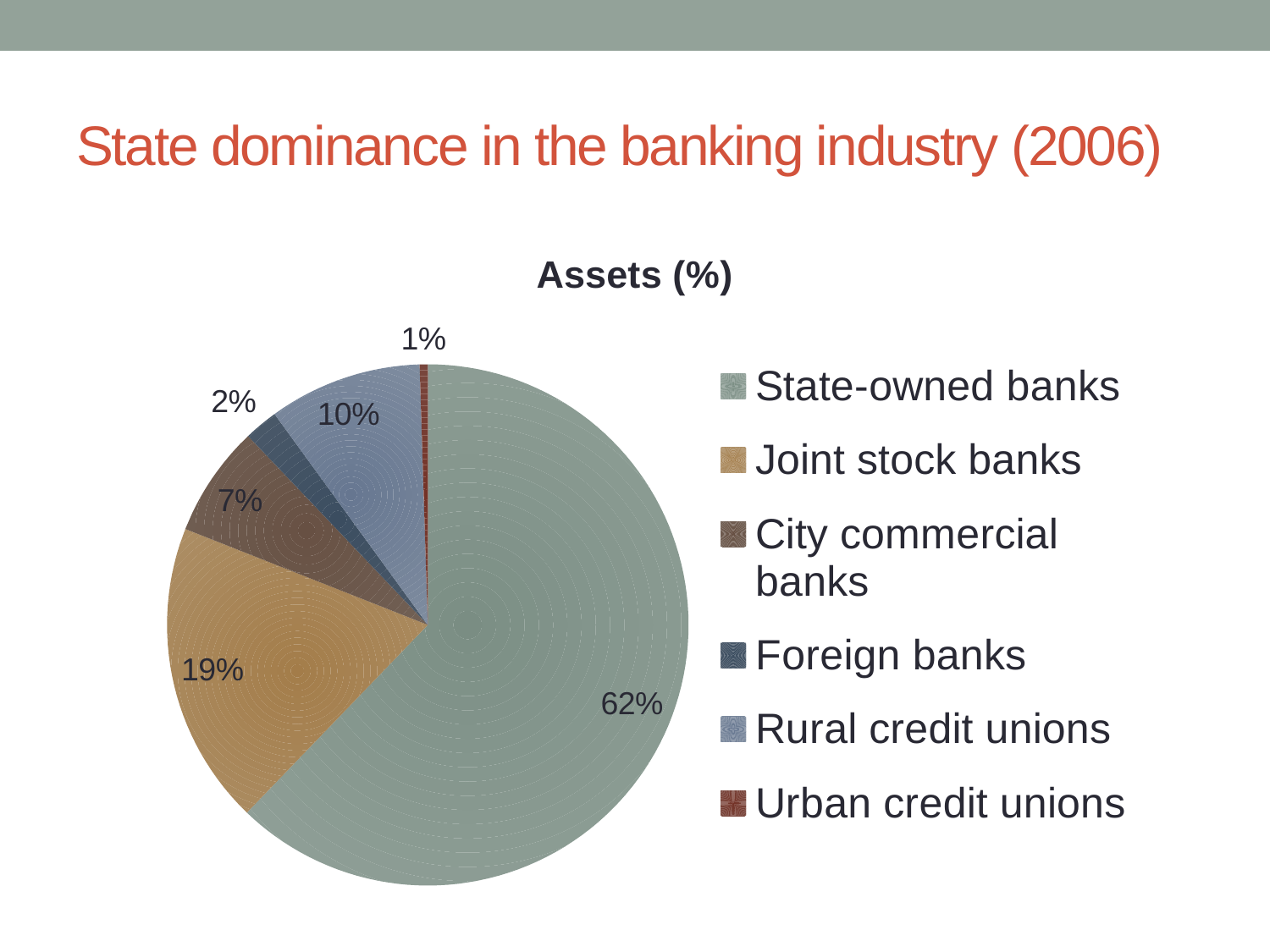
What kind of chart is shown on the slide? Pie chart How many categories are shown in the pie chart? 6 What share of assets do City commercial banks hold? 7% Which holds a larger share of assets, Rural credit unions or City commercial banks? Rural credit unions What share of assets do Rural credit unions hold? 10% Which category holds the largest share of assets? State-owned banks What is the difference in asset share between State-owned banks and Joint stock banks? 43% Which category holds the smallest share of assets? Urban credit unions What share of assets do Urban credit unions hold? 1% What share of assets do State-owned banks hold? 62% What is the title of the chart? Assets (%) What share of assets do Joint stock banks hold? 19%